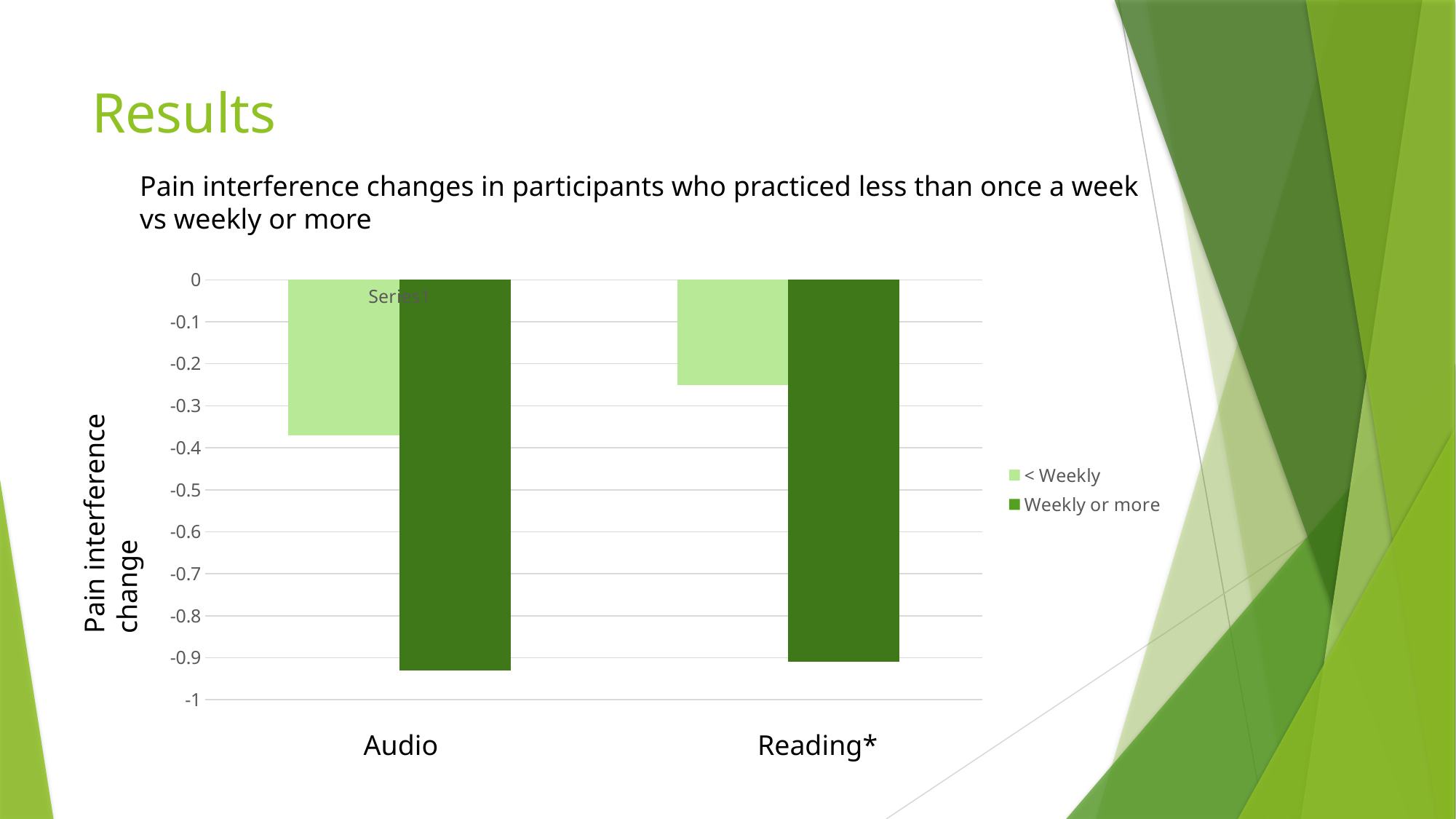
How many categories are shown on the x axis of the chart? 2 Is the 'Weekly or more' value for Reading* greater or less than -0.5? less Is the '< Weekly' value for Reading* greater or less than -0.3? greater What is the label on the vertical axis of the chart? Pain interference change For the '< Weekly' series, which category has the larger (closer to zero) value, Audio or Reading*? Reading* Which bar in the chart has the highest (closest to zero) value? < Weekly for Reading* What kind of chart is shown on the slide? bar chart What are the two series listed in the chart's legend? < Weekly; Weekly or more For Audio, which series shows the larger decrease in pain interference, '< Weekly' or 'Weekly or more'? Weekly or more Is the '< Weekly' value for Audio greater or less than -0.3? less How many series does the chart's legend list? 2